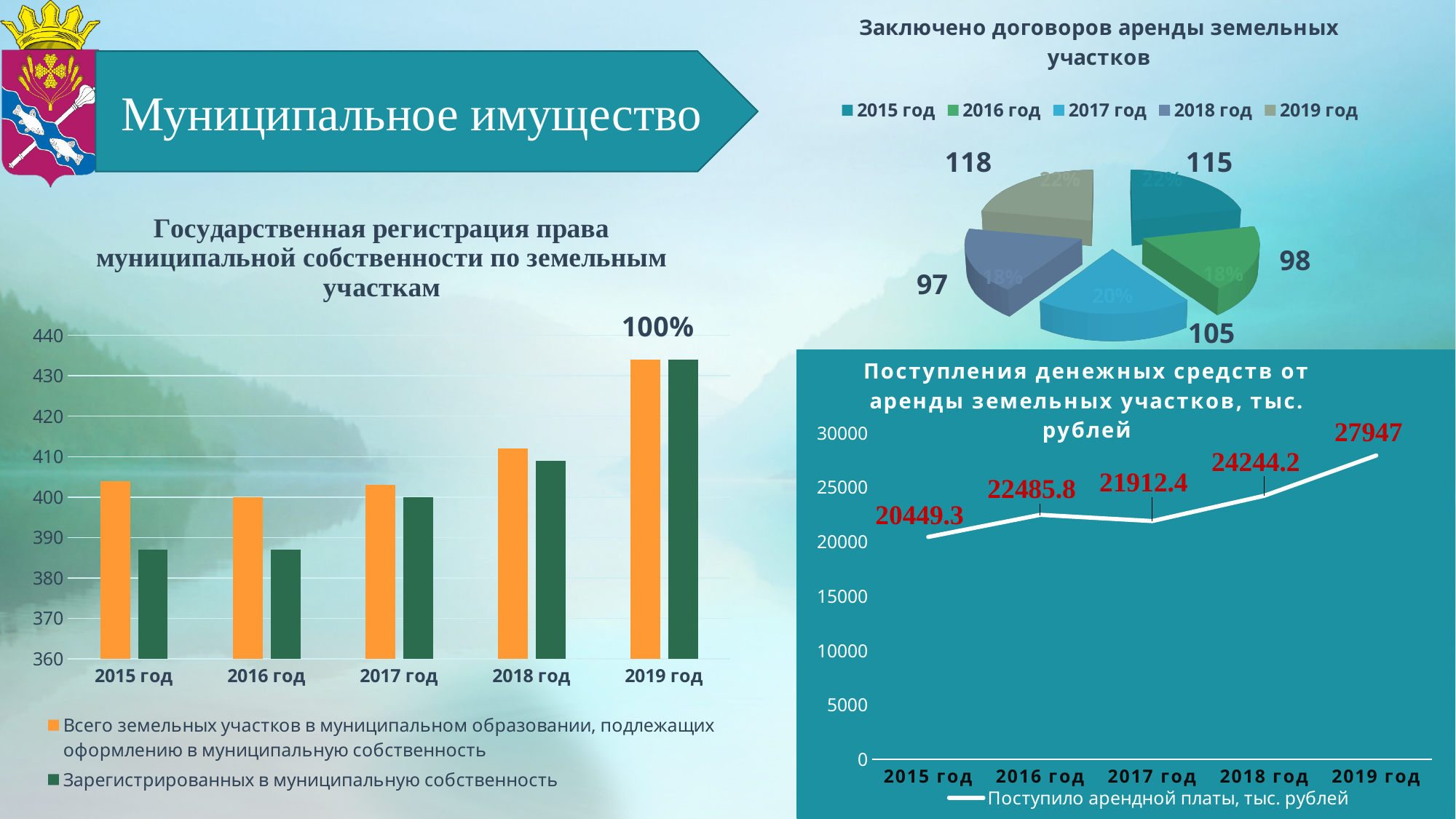
In the line chart 'Поступления денежных средств от аренды земельных участков, тыс. рублей', which year has the highest value? 2019 год In the pie chart 'Заключено договоров аренды земельных участков', which year has the smallest number of contracts? 2018 год In the line chart 'Поступления денежных средств от аренды земельных участков, тыс. рублей', which is larger: the value for 2016 год or 2017 год? 2016 год In the pie chart 'Заключено договоров аренды земельных участков', how many contracts were concluded in 2019 год? 118 In the line chart 'Поступления денежных средств от аренды земельных участков, тыс. рублей', what is the difference between the values for 2019 год and 2015 год? 7497.7 In the pie chart 'Заключено договоров аренды земельных участков', what share of the pie does 2017 год take? 20% How many slices does the pie chart 'Заключено договоров аренды земельных участков' have? 5 How many series does the legend of the chart 'Государственная регистрация права муниципальной собственности по земельным участкам' list? 2 What type of chart is 'Государственная регистрация права муниципальной собственности по земельным участкам'? bar chart In the line chart 'Поступления денежных средств от аренды земельных участков, тыс. рублей', what is the value for 2018 год? 24244.2 In the chart 'Государственная регистрация права муниципальной собственности по земельным участкам', is the value of 'Зарегистрированных в муниципальную собственность' for 2015 год greater or less than 400? less In the pie chart 'Заключено договоров аренды земельных участков', what is the difference between the values for 2019 год and 2016 год? 20